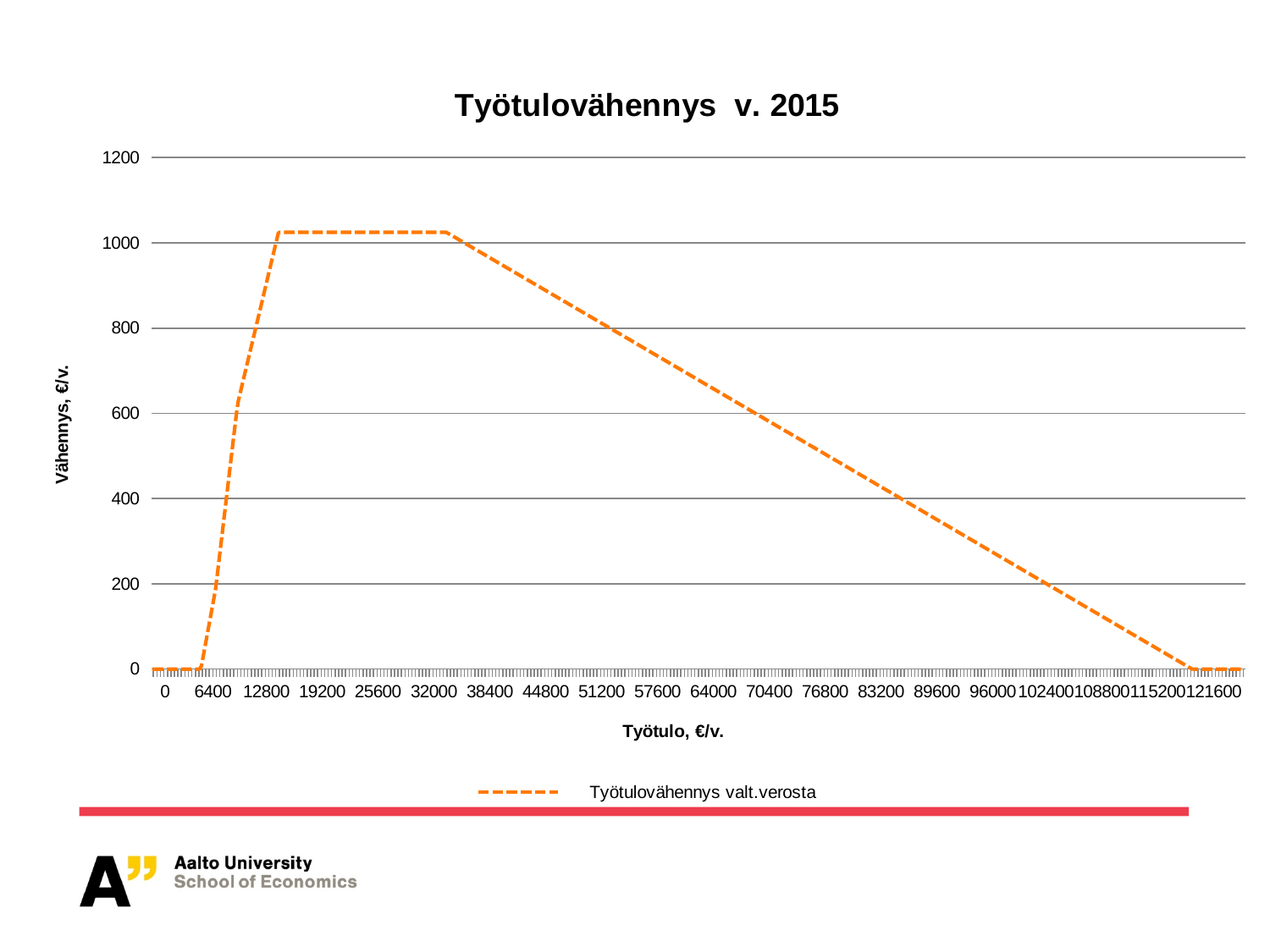
What kind of chart is shown on the slide? line chart How many series does the legend list? 1 Does the value of Työtulovähennys valt.verosta rise or fall as Työtulo increases from 38400 to 115200? fall What is the value of Työtulovähennys valt.verosta at a Työtulo of 0? 0 Is the value of Työtulovähennys valt.verosta at a Työtulo of 44800 greater or less than 800? greater Is the value of Työtulovähennys valt.verosta at a Työtulo of 6400 greater or less than 400? less What is the title of the chart? Työtulovähennys v. 2015 Which is larger, the value of Työtulovähennys valt.verosta at a Työtulo of 25600 or at 102400? 25600 Is the value of Työtulovähennys valt.verosta at a Työtulo of 89600 greater or less than 400? less Does the value of Työtulovähennys valt.verosta rise or fall as Työtulo increases from 6400 to 12800? rise What is the name of the series shown in the legend? Työtulovähennys valt.verosta